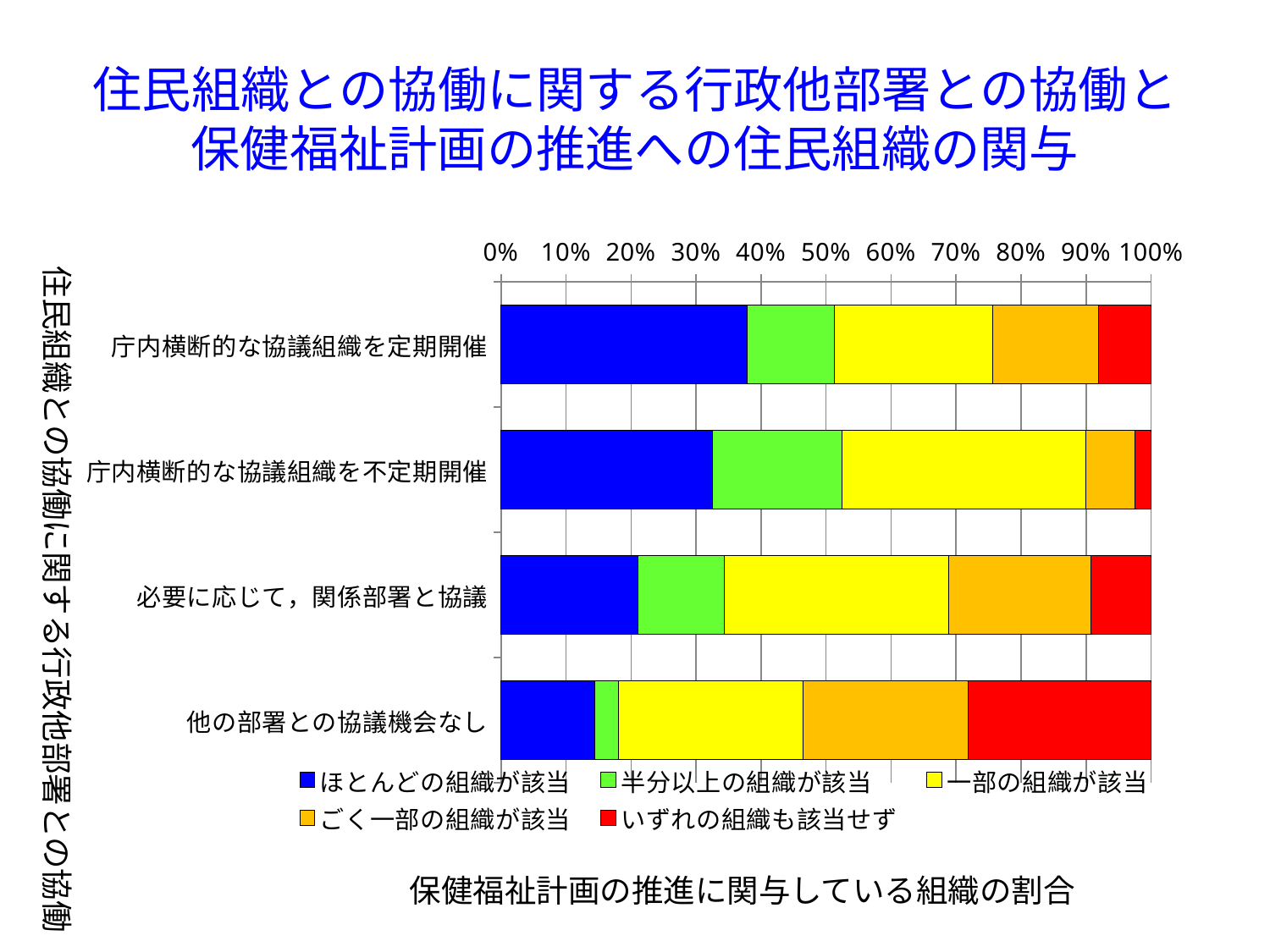
Is the ほとんどの組織が該当 share for 他の部署との協議機会なし greater or less than 20%? less Which category has the smallest share for いずれの組織も該当せず (red)? 庁内横断的な協議組織を不定期開催 Which category has the largest share for ほとんどの組織が該当 (blue)? 庁内横断的な協議組織を定期開催 Which category has the smallest share for ほとんどの組織が該当 (blue)? 他の部署との協議機会なし Is the ほとんどの組織が該当 share for 庁内横断的な協議組織を定期開催 greater or less than 30%? greater Which has the larger 半分以上の組織が該当 (green) share: 庁内横断的な協議組織を定期開催 or 庁内横断的な協議組織を不定期開催? 庁内横断的な協議組織を不定期開催 What kind of chart is shown on the slide? Stacked bar chart Is the いずれの組織も該当せず share for 他の部署との協議機会なし greater or less than 20%? greater What is the title of the horizontal (percentage) axis? 保健福祉計画の推進に関与している組織の割合 How many series does the legend list? 5 Which category has the largest share for いずれの組織も該当せず (red)? 他の部署との協議機会なし How many categories (bars) are plotted on the y axis? 4